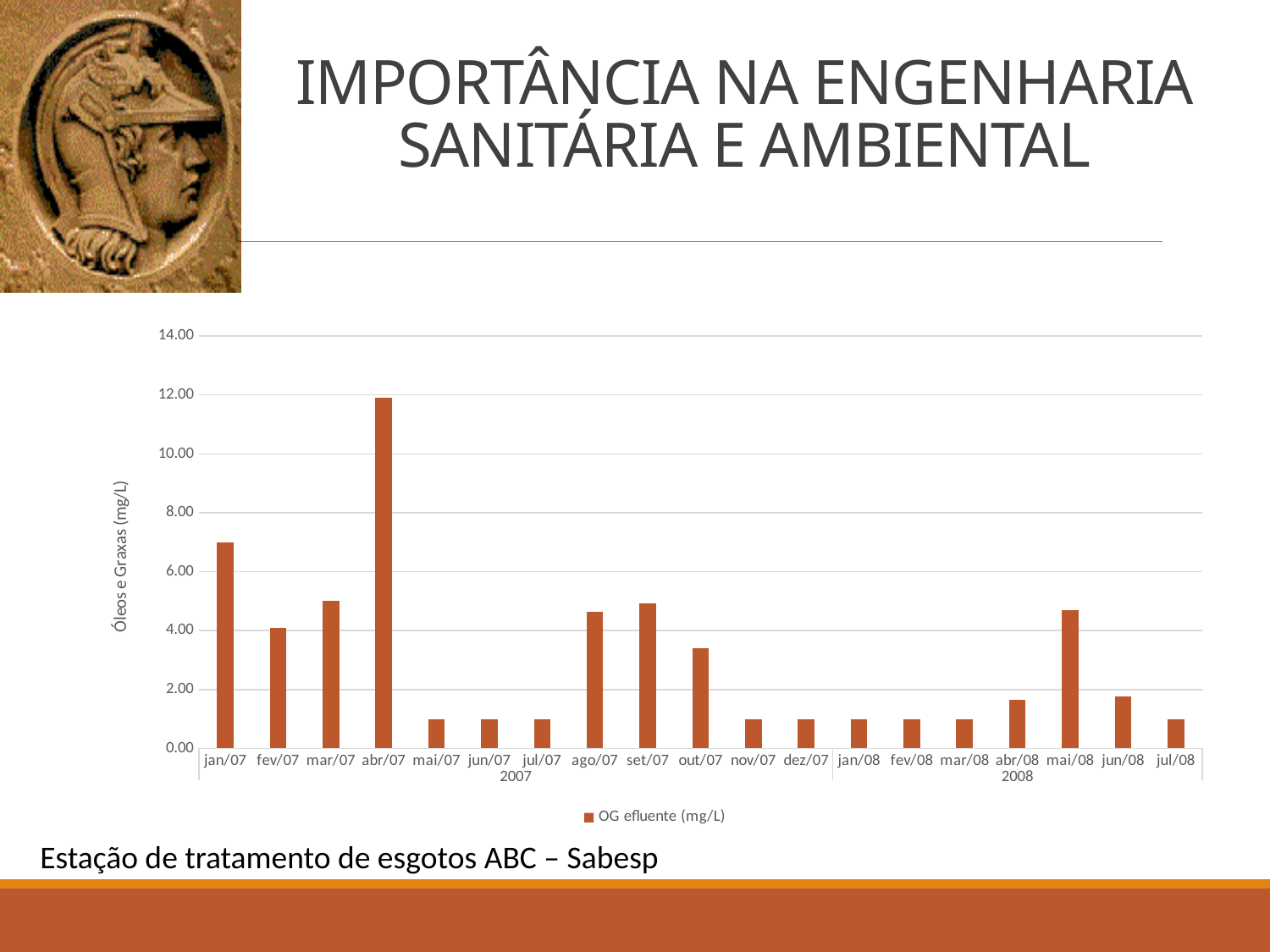
What kind of chart is shown on the slide? bar chart What series name is shown in the legend? OG efluente (mg/L) How many series does the legend list? 1 Is the value for abr/07 greater or less than 10.00? greater Is the value for mai/07 greater or less than 2.00? less Which is larger, the value for mai/08 or the value for jun/08? mai/08 Is the value for jan/07 greater or less than 6.00? greater Which is larger, the value for jan/07 or the value for fev/07? jan/07 What is the label of the y axis? Óleos e Graxas (mg/L) Which month has the highest value for OG efluente (mg/L)? abr/07 How many months (categories) are plotted on the x axis? 19